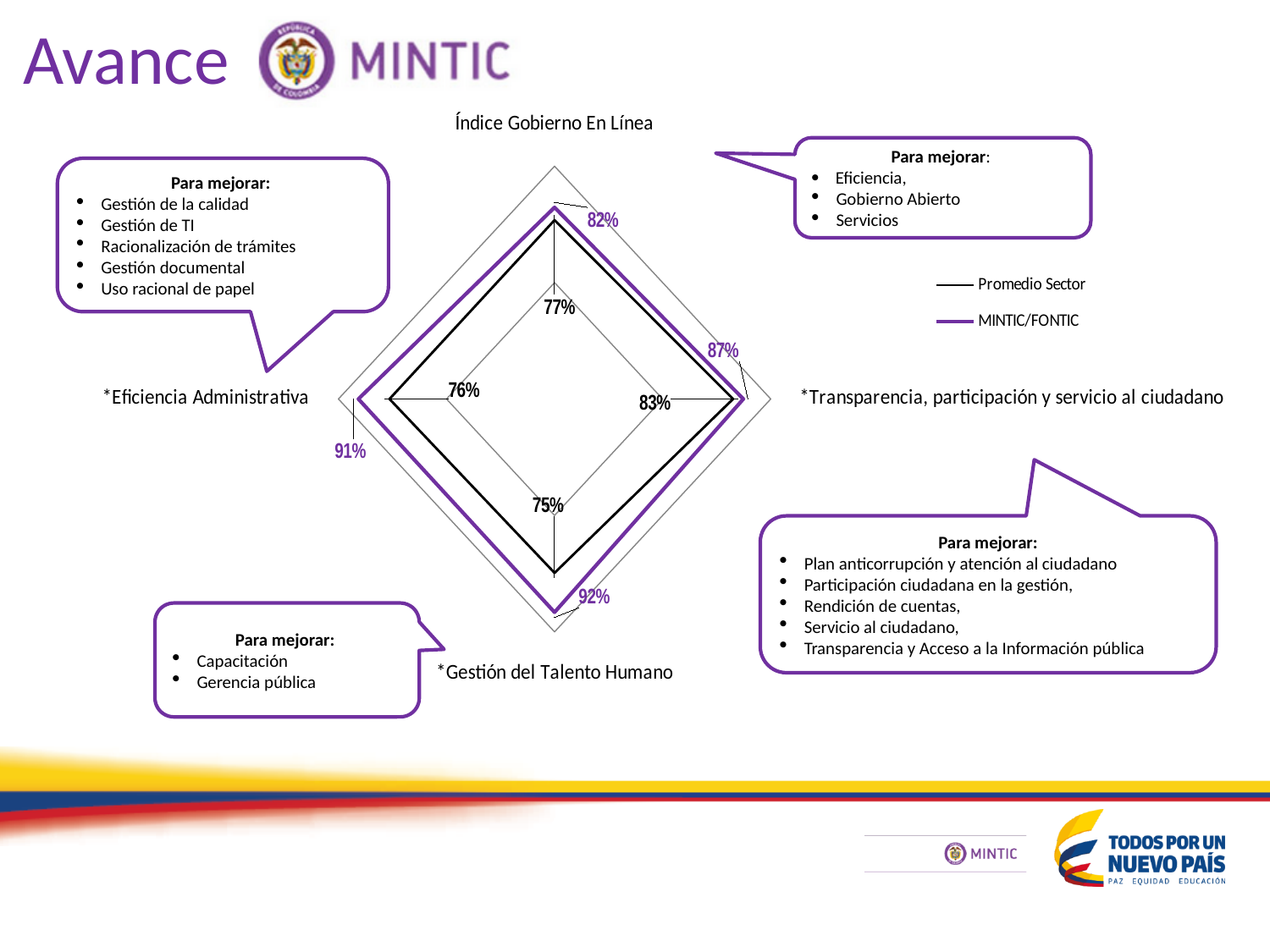
Which series has the larger value for Eficiencia Administrativa, MINTIC/FONTIC or Promedio Sector? MINTIC/FONTIC What kind of chart is shown on the slide? Radar chart What is the MINTIC/FONTIC value for Índice Gobierno En Línea? 82% On which axis does MINTIC/FONTIC reach its highest value? Gestión del Talento Humano What is the difference between the MINTIC/FONTIC and Promedio Sector values for Transparencia, participación y servicio al ciudadano? 4% How many axes (categories) does the radar chart have? 4 What is the Promedio Sector value for Índice Gobierno En Línea? 77% On which axis does Promedio Sector have its lowest value? Gestión del Talento Humano What is the MINTIC/FONTIC value for Gestión del Talento Humano? 92% How many series does the legend list? 2 What is the Promedio Sector value for Eficiencia Administrativa? 76% What are the two series named in the legend? Promedio Sector and MINTIC/FONTIC